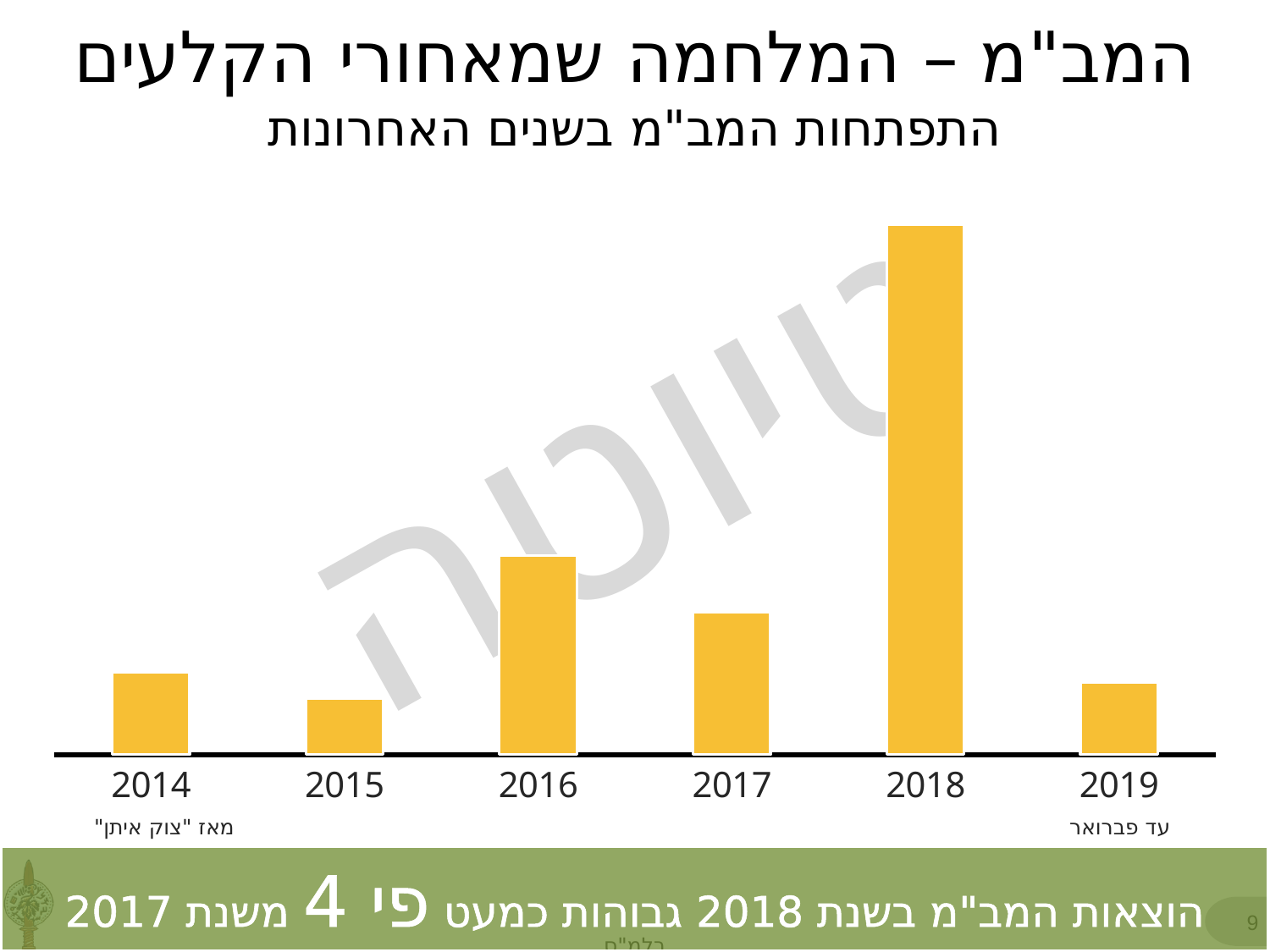
Which year has the larger value, 2014 or 2015? 2014 Does the value rise or fall from 2018 to 2019? Fall Does the value rise or fall from 2017 to 2018? Rise What colour are the bars in the chart? Yellow What is the first year shown on the x axis of the chart? 2014 Which year has the larger value, 2016 or 2017? 2016 Which year has the highest bar in the chart? 2018 Which year has the larger value, 2018 or 2016? 2018 How many years are shown on the x axis of the chart? 6 What kind of chart is shown on the slide? Bar chart Which year has the lowest bar in the chart? 2015